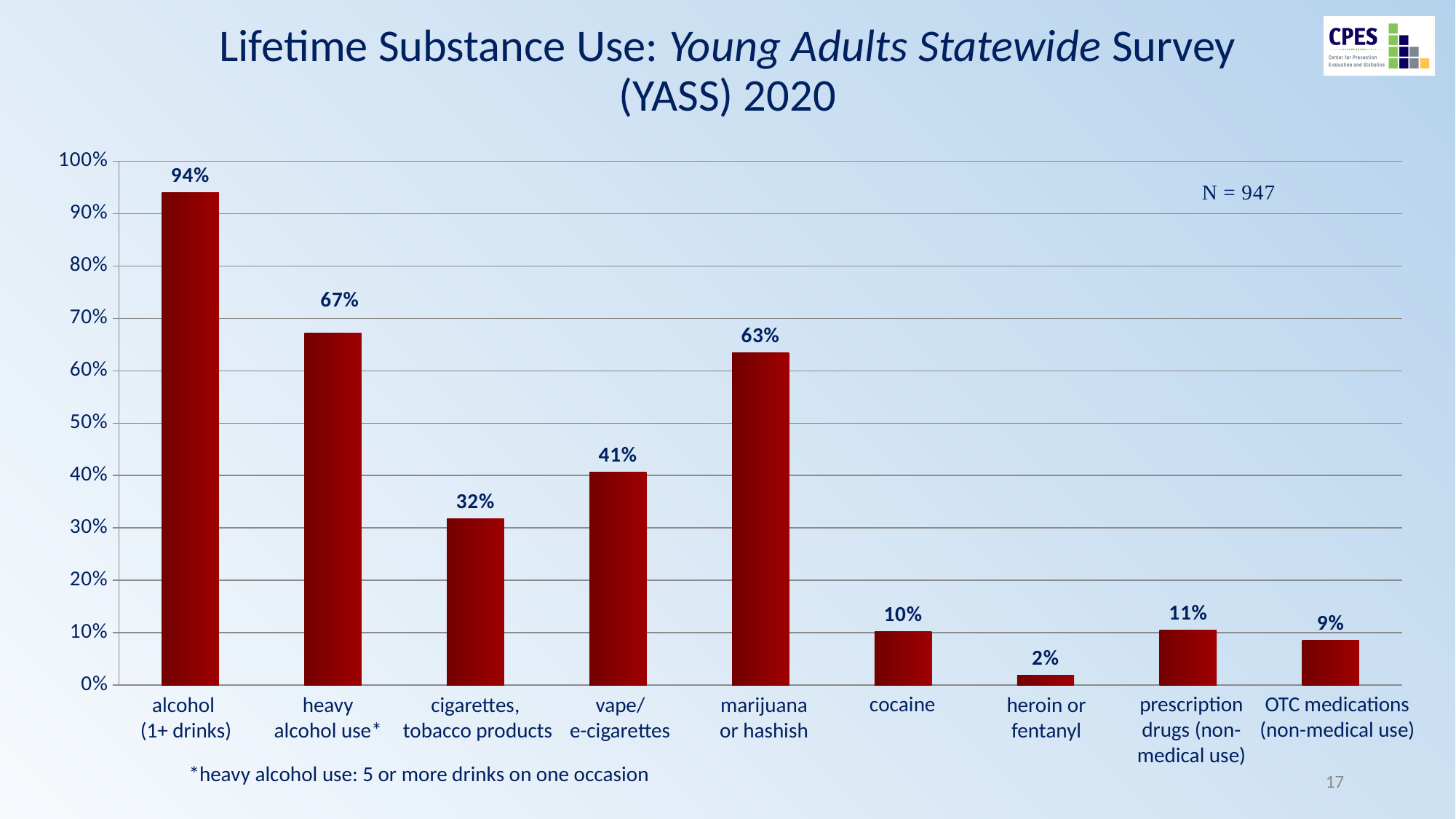
Which substance has the highest lifetime use value? alcohol (1+ drinks) Which is larger, the value for marijuana or hashish or the value for vape/e-cigarettes? marijuana or hashish What kind of chart is shown on the slide? bar chart Which substance has the lowest lifetime use value? heroin or fentanyl What sample size (N) is shown on the chart? N = 947 How many substance categories are shown on the chart? 9 Is the value for cigarettes/tobacco products greater or less than 40%? less What is the value for marijuana or hashish? 63% What is the difference between the values for heavy alcohol use and cigarettes/tobacco products? 35% What is the lifetime use value for alcohol (1+ drinks)? 94% What is the value for vape/e-cigarettes? 41% What is the value for heroin or fentanyl? 2%